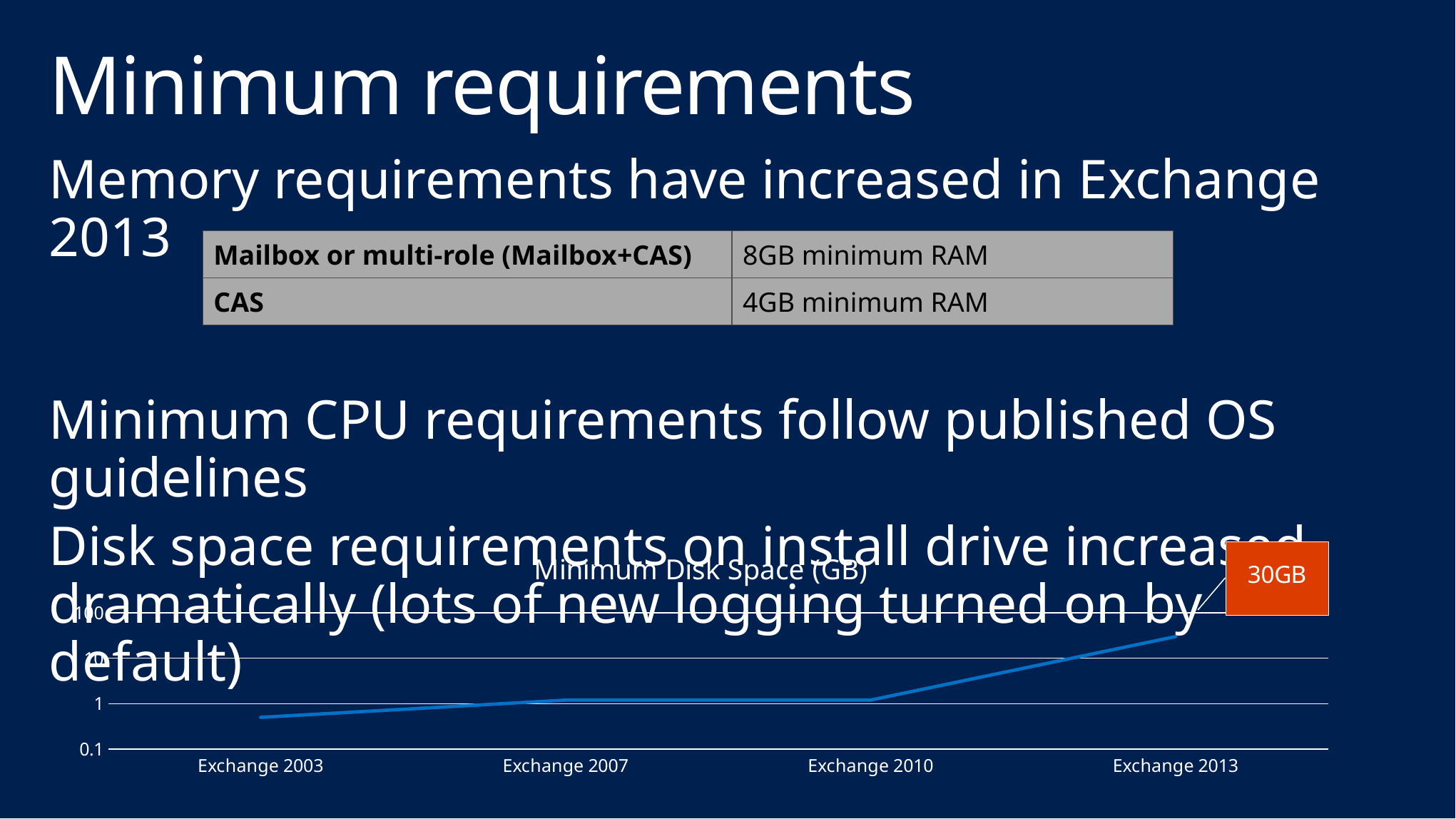
Which has the larger minimum disk space, Exchange 2003 or Exchange 2013? Exchange 2013 Is the minimum disk space for Exchange 2013 greater or less than 10? greater How many Exchange versions are plotted on the x axis of the chart? 4 What is the title of the chart? Minimum Disk Space (GB) Which Exchange version has the lowest minimum disk space in the chart? Exchange 2003 Is the minimum disk space for Exchange 2003 greater or less than 1? less What is the lowest tick value shown on the chart's y axis? 0.1 Is the minimum disk space for Exchange 2010 greater or less than 10? less Which Exchange version has the highest minimum disk space in the chart? Exchange 2013 What minimum disk space value is called out for Exchange 2013 in the chart? 30GB What kind of chart is shown on the slide? line chart Do the minimum disk space values rise or fall from Exchange 2003 to Exchange 2013? rise